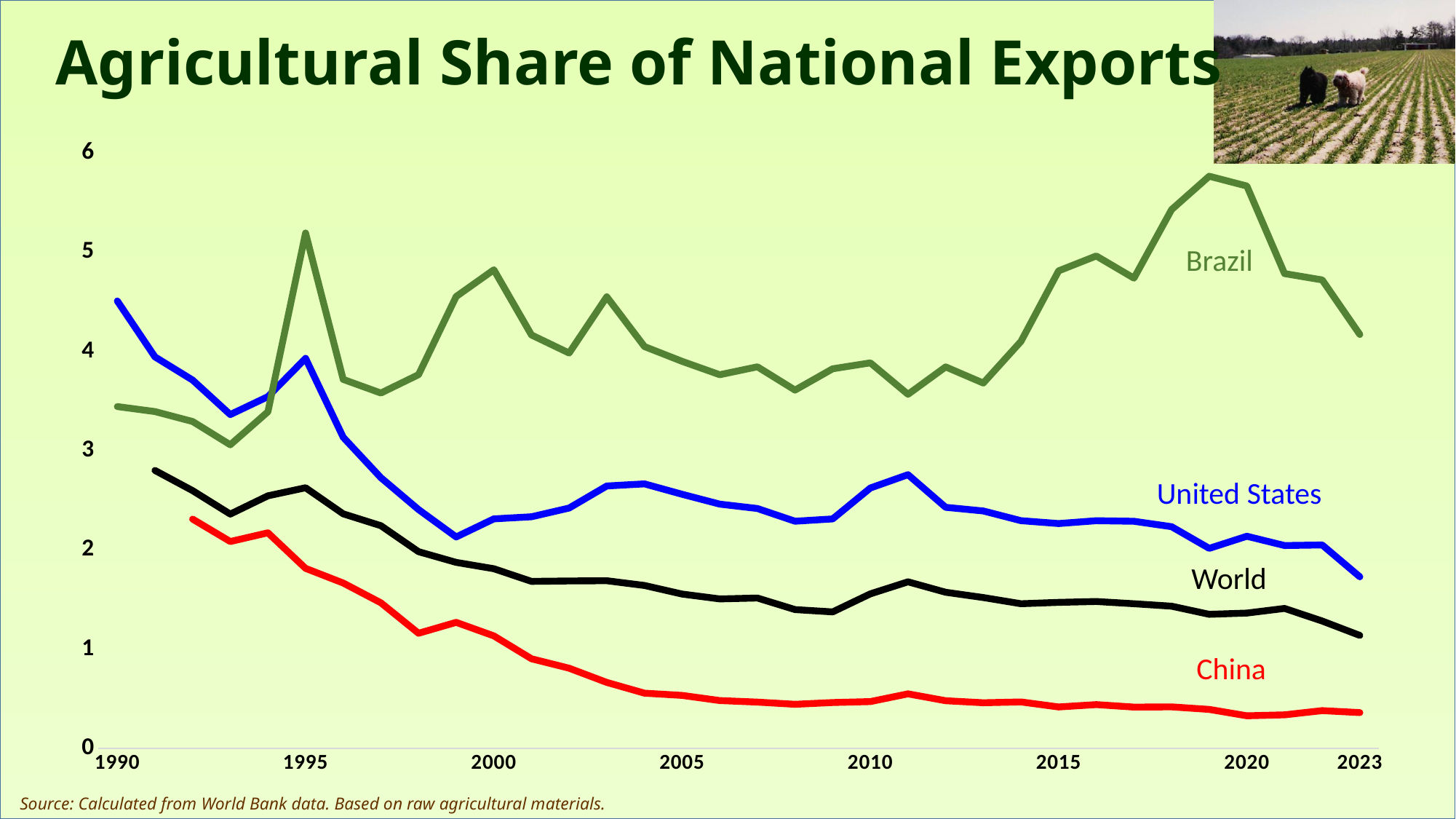
Is the value for the United States in 1990 greater or less than 4? greater Does the China line generally rise or fall from 1992 to 2023? fall Is the value for World in 2023 greater or less than 2? less Which series has the highest value in 2023? Brazil What kind of chart is shown on the slide? line chart How many series (countries/regions) are plotted on the chart? 4 In 1990, which is higher: the United States or Brazil? United States Which series is drawn in red? China Is the value for Brazil in 2019 greater or less than 5? greater Which series has the lowest value in 2023? China What is the title of the chart? Agricultural Share of National Exports